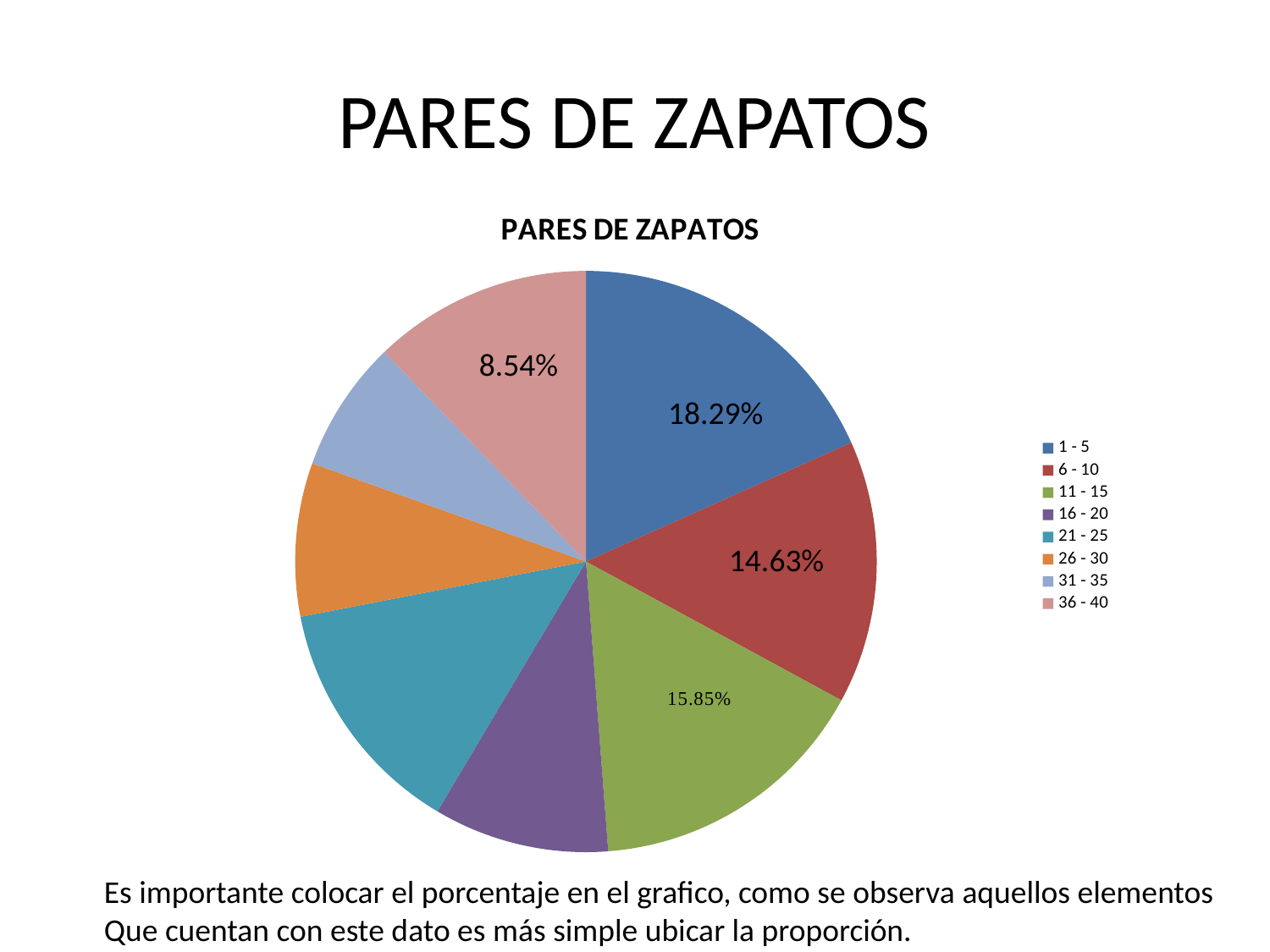
How many slices does the pie chart have? 8 What percentage is shown for the 6 - 10 category? 14.63% How many entries does the legend list? 8 What is the title of the chart? PARES DE ZAPATOS Which category has the largest slice of the pie? 1 - 5 What percentage is shown for the 1 - 5 category? 18.29% Which is larger, the slice for 1 - 5 or the slice for 6 - 10? 1 - 5 Which is larger, the slice for 11 - 15 or the slice for 6 - 10? 11 - 15 What is the difference in percentage points between the 1 - 5 slice and the 6 - 10 slice? 3.66 What is the combined share of the 1 - 5 and 6 - 10 slices? 32.92% What percentage is shown for the 11 - 15 category? 15.85% What kind of chart is shown on the slide? pie chart